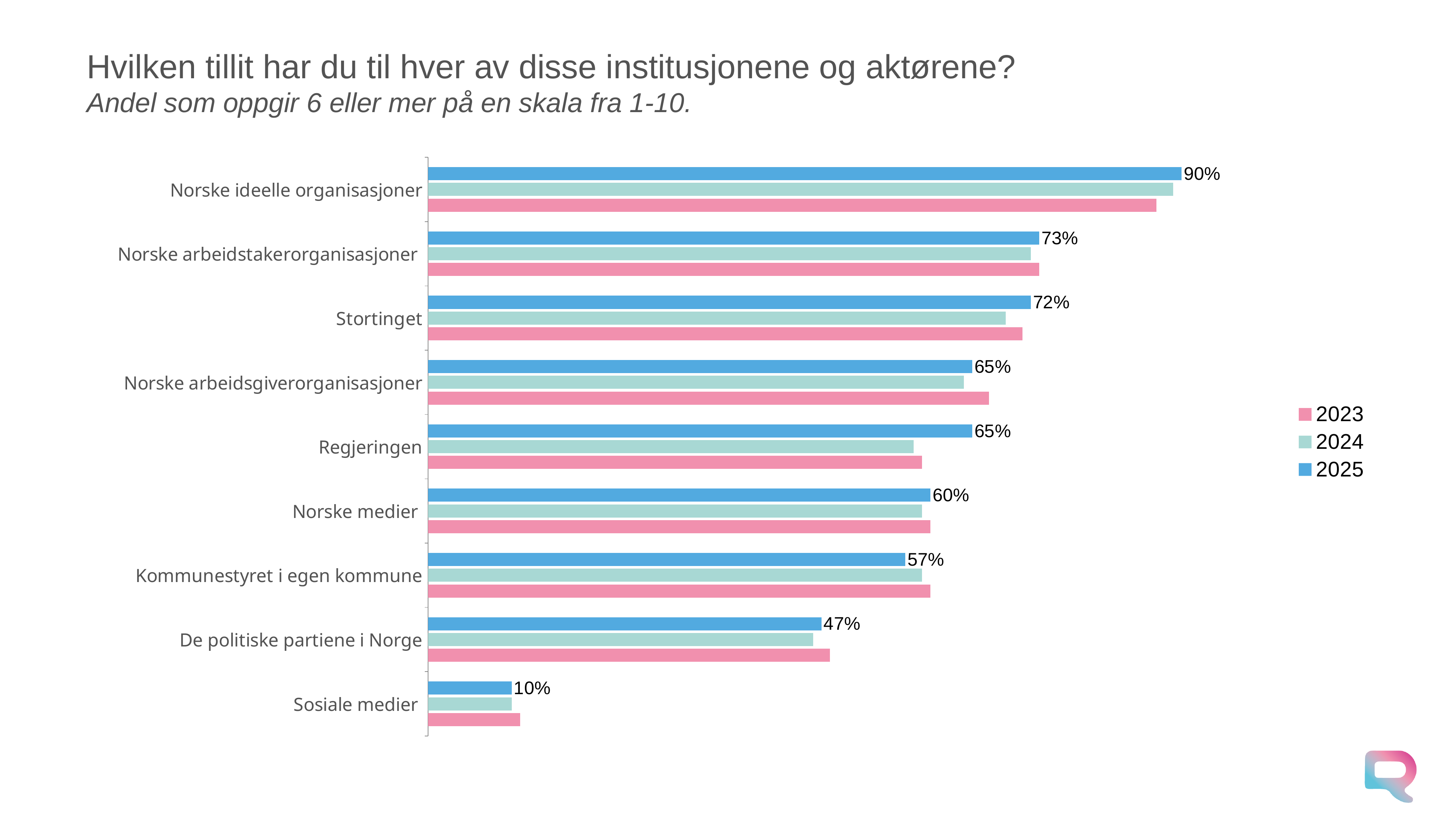
Which category has the highest 2025 value? Norske ideelle organisasjoner Which category has the lowest 2025 value? Sosiale medier Which legend entry is shown in pink? 2023 What is the 2025 value for Norske ideelle organisasjoner? 90% What is the 2025 value for Sosiale medier? 10% What is the 2025 value for De politiske partiene i Norge? 47% What kind of chart is shown on the slide? bar chart How many institutions or actors are listed on the chart? 9 How many series does the legend list? 3 For Norske ideelle organisasjoner, which year has the larger value, 2023 or 2025? 2025 What is the 2025 value for Stortinget? 72% What is the difference between the 2025 values for Norske arbeidstakerorganisasjoner and Kommunestyret i egen kommune? 16%